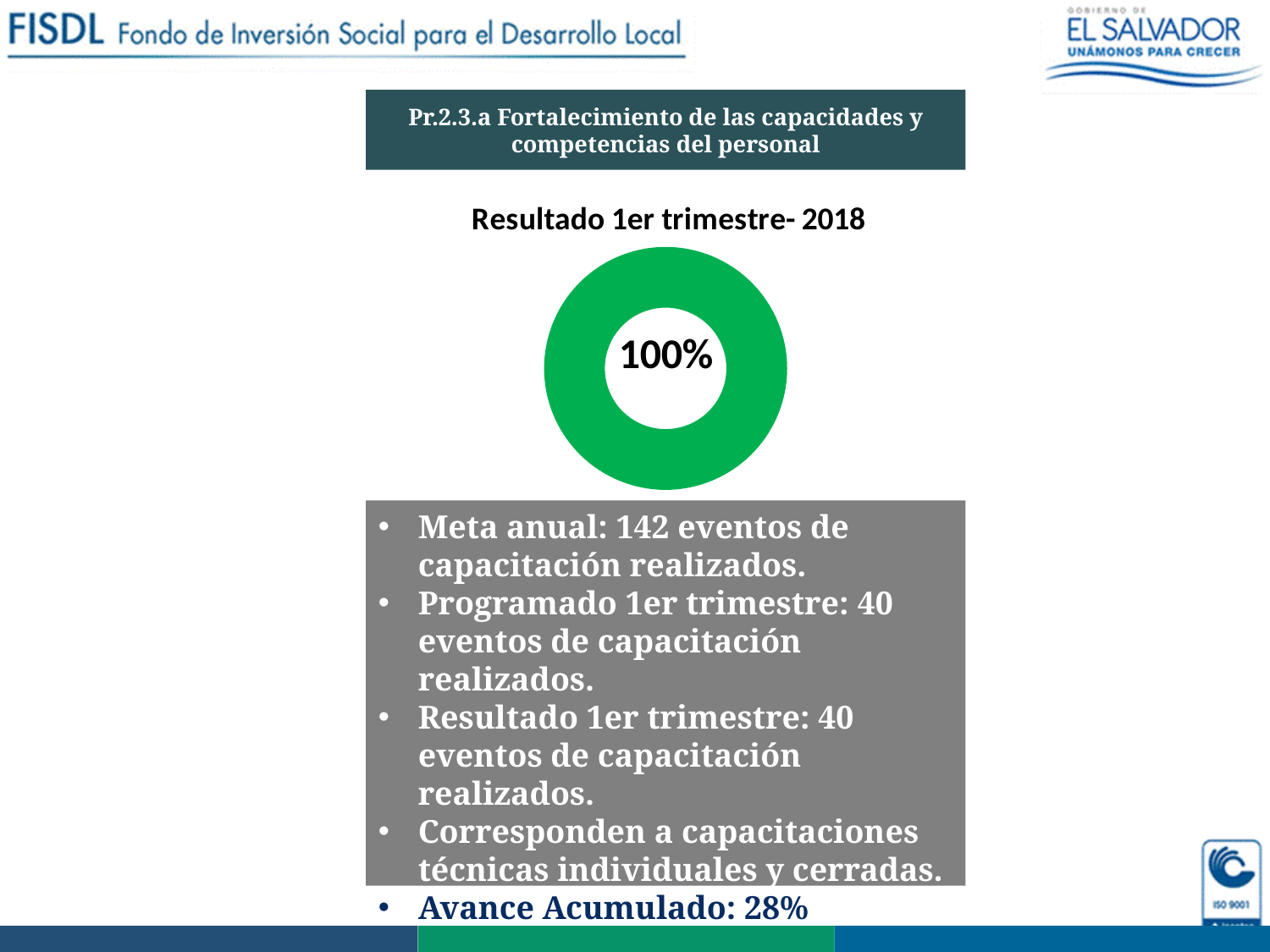
What share of the doughnut chart does the green slice occupy? 100% How many distinct slices are visible in the doughnut chart? 1 What kind of chart is shown on the slide? Doughnut chart What is the title shown above the doughnut chart? Resultado 1er trimestre- 2018 What percentage is displayed in the centre of the doughnut chart? 100% What colour is the ring of the doughnut chart? Green Is the value shown in the doughnut chart greater or less than 50%? greater